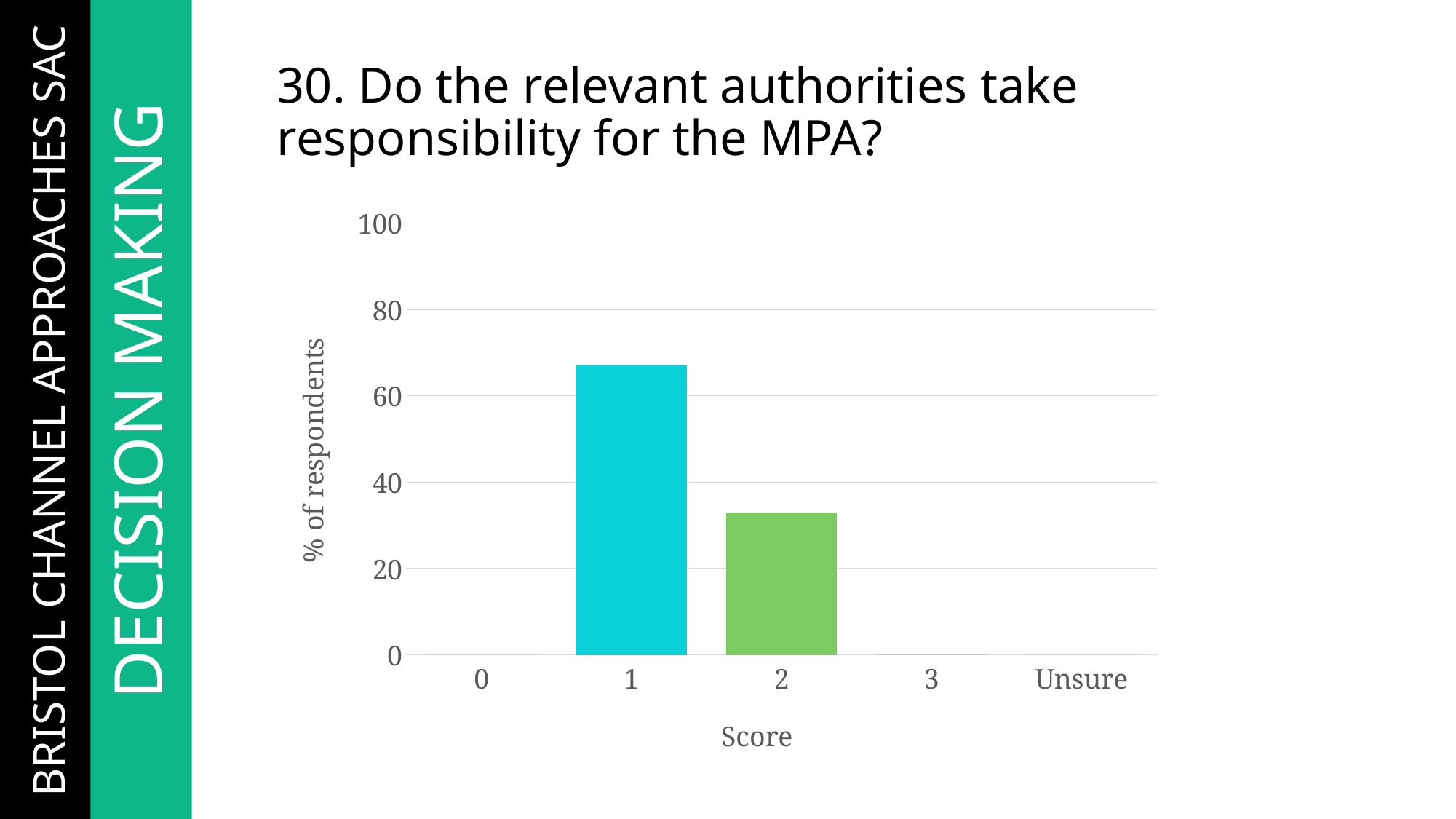
Is the value for score 1 greater or less than 80? less What kind of chart is shown on the slide? bar chart What is the label of the y axis? % of respondents Is the value for score 2 greater or less than 40? less Which score category has the highest percentage of respondents? 1 What is the label of the x axis? Score How many score categories are shown on the x axis? 5 What is the percentage of respondents for score 3? 0 What is the percentage of respondents for the Unsure category? 0 Is the value for score 1 greater or less than 60? greater Which is larger, the value for score 1 or the value for score 2? score 1